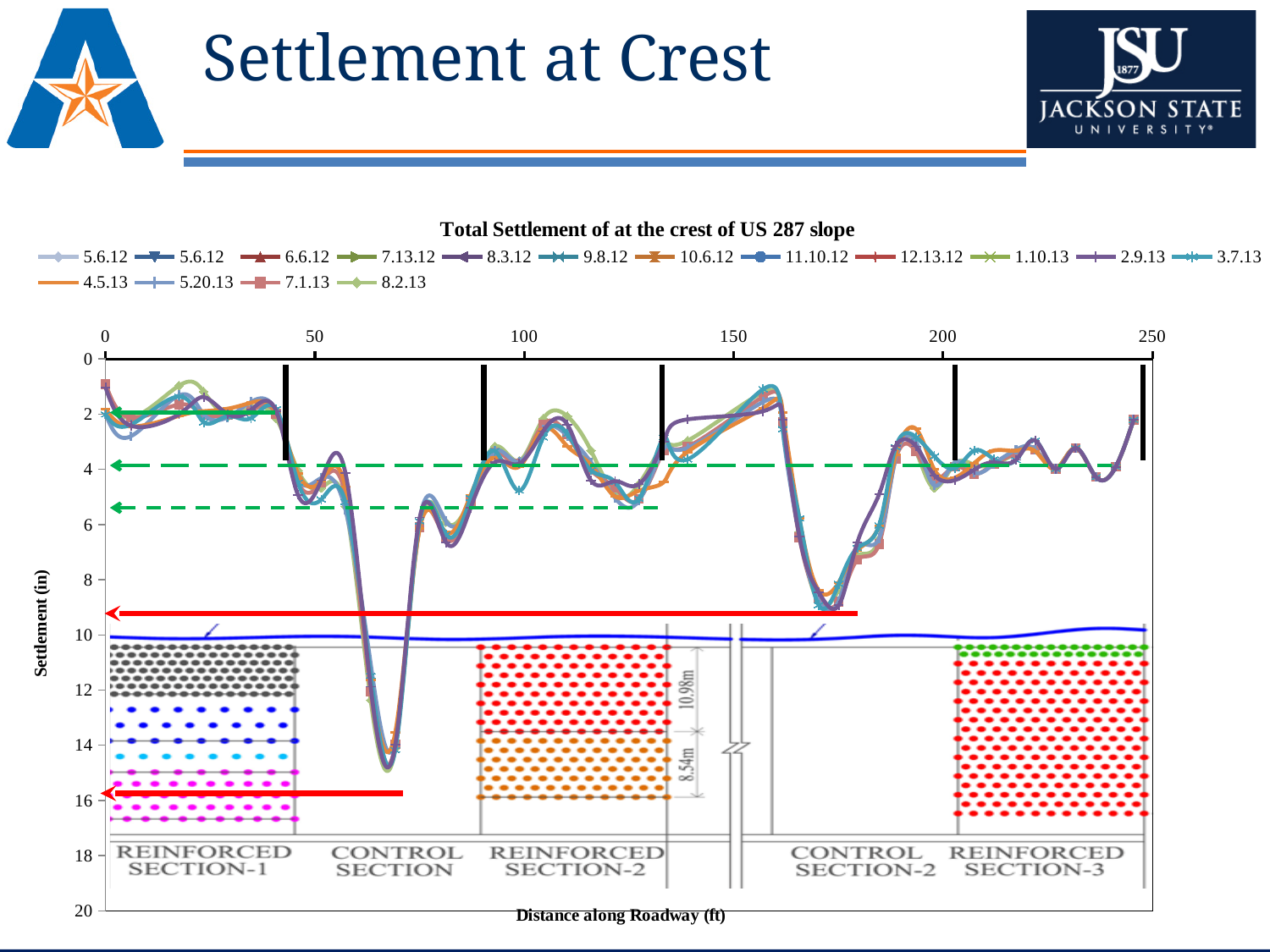
Is the settlement at about 65 ft larger or smaller than the settlement at about 170 ft? larger What kind of chart is shown on the slide? line chart How many series does the chart legend list? 16 Which labeled roadway section shows the largest settlement? Control Section Is the settlement at a distance of 0 ft greater or less than 4 in? less Is the settlement at a distance of about 170 ft greater or less than 6 in? greater What is the title of the chart? Total Settlement of at the crest of US 287 slope What is the highest tick value shown on the vertical axis? 20 Is the settlement at a distance of about 160 ft greater or less than 4 in? less What is the label of the vertical axis? Settlement (in)